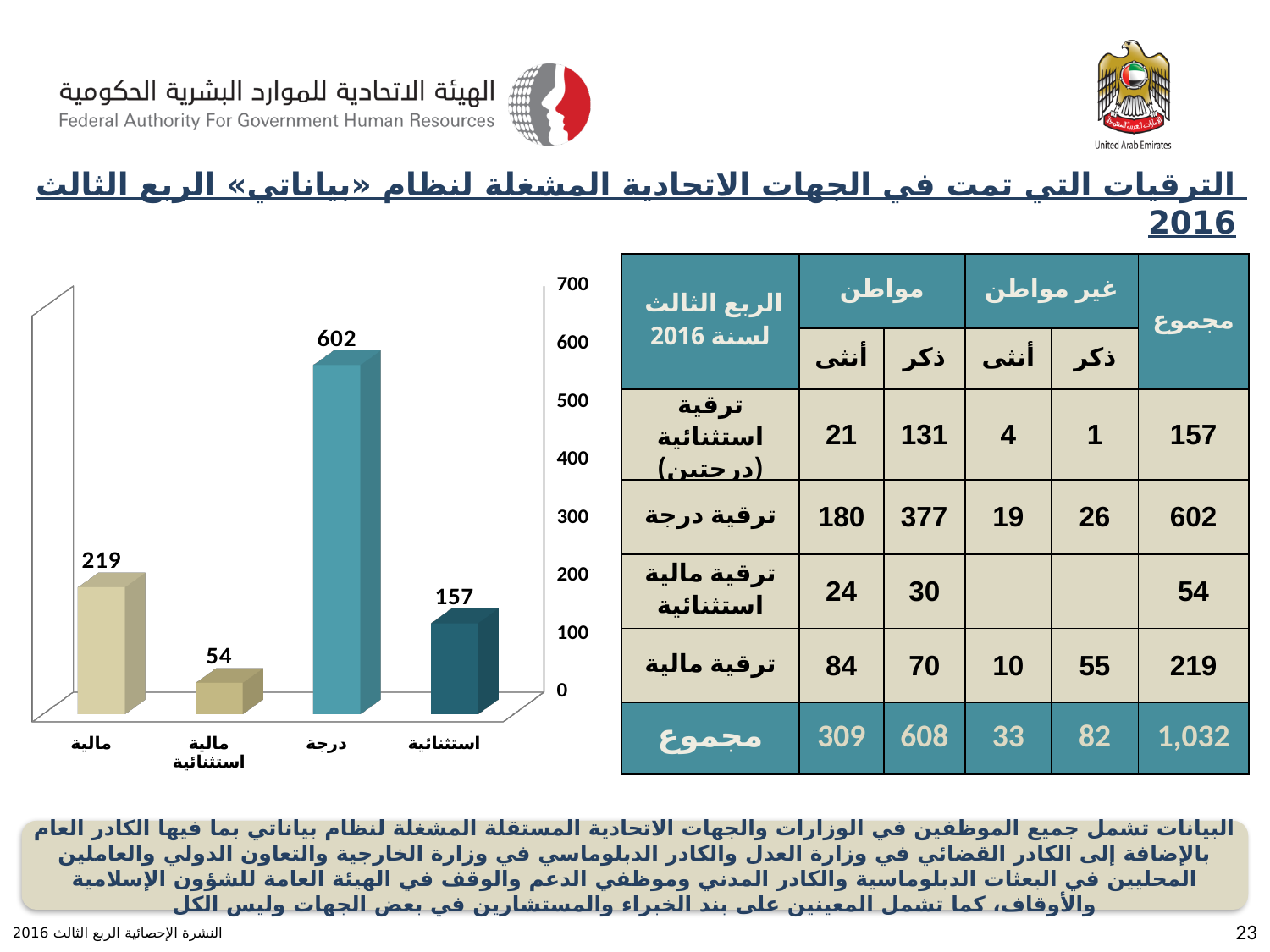
How many categories are shown on the x axis of the chart? 4 What is the value of the bar labelled "مالية استثنائية"? 54 What is the value of the bar labelled "مالية"? 219 Which category has the lowest bar in the chart? مالية استثنائية What is the difference between the values for "درجة" and "مالية"? 383 What is the value of the bar labelled "درجة"? 602 Is the value for "درجة" greater or less than 500? greater What is the difference between the values for "استثنائية" and "مالية استثنائية"? 103 Which category has the highest bar in the chart? درجة Which is larger, the value for "مالية" or the value for "استثنائية"? مالية What is the value of the bar labelled "استثنائية"? 157 What kind of chart is shown on the slide? bar chart